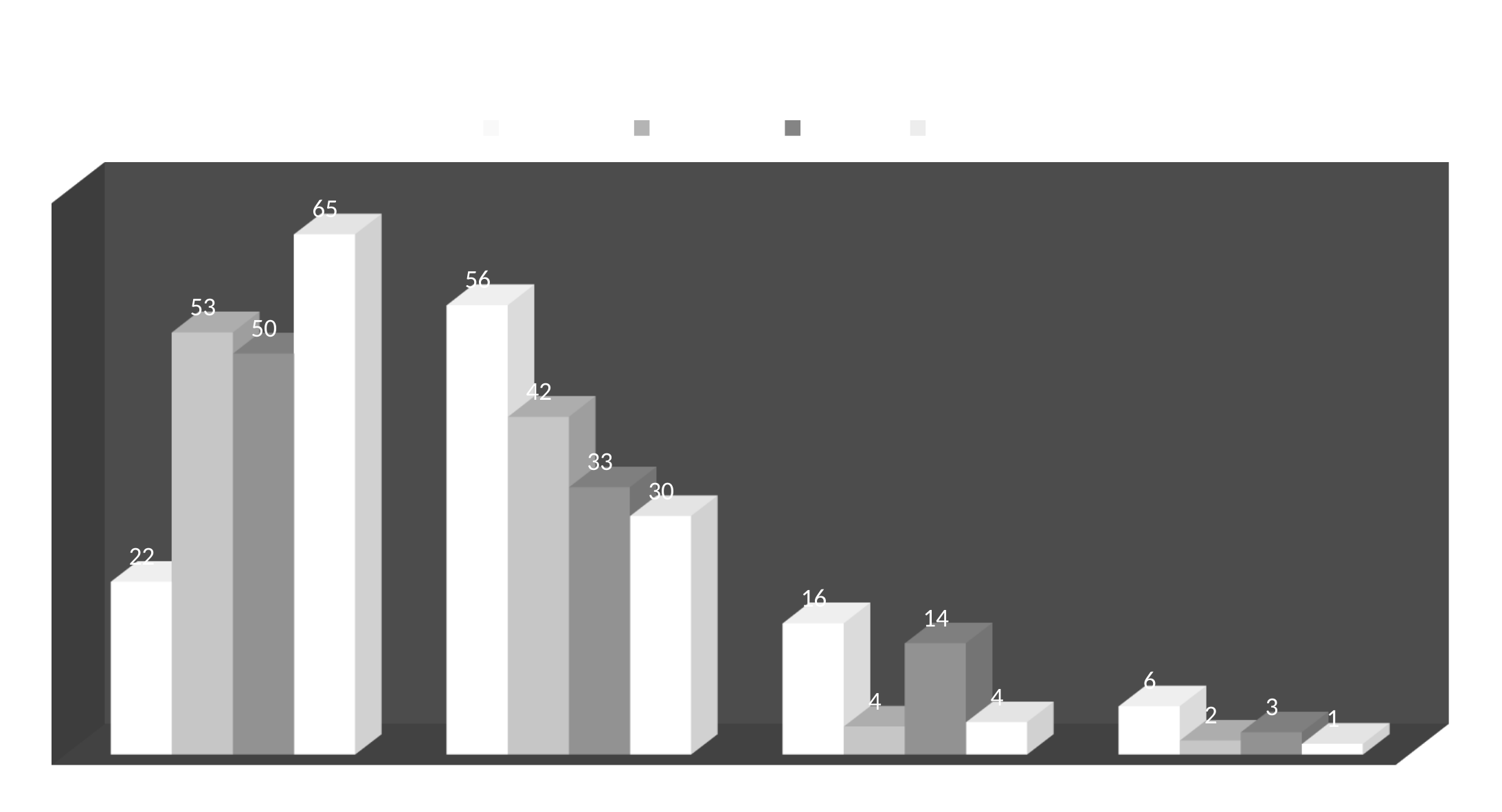
How many groups of bars are plotted along the x axis? 4 How many colour swatches does the legend show? 4 What is the highest value labelled anywhere on the chart? 65 What is the value of the third bar in the third group from the left? 14 Which is larger: the first bar in the second group (56) or the first bar in the leftmost group (22)? 56 What kind of chart is shown on the slide? bar chart What is the difference between the tallest bar (65) and the shortest bar (22) in the leftmost group? 43 Do the values of the first bar in each group rise or fall from the second group to the rightmost group? fall What is the value of the first bar in the second group from the left? 56 What is the value of the first (leftmost) bar in the leftmost group? 22 What is the lowest value labelled anywhere on the chart? 1 What is the value of the tallest bar in the leftmost group? 65